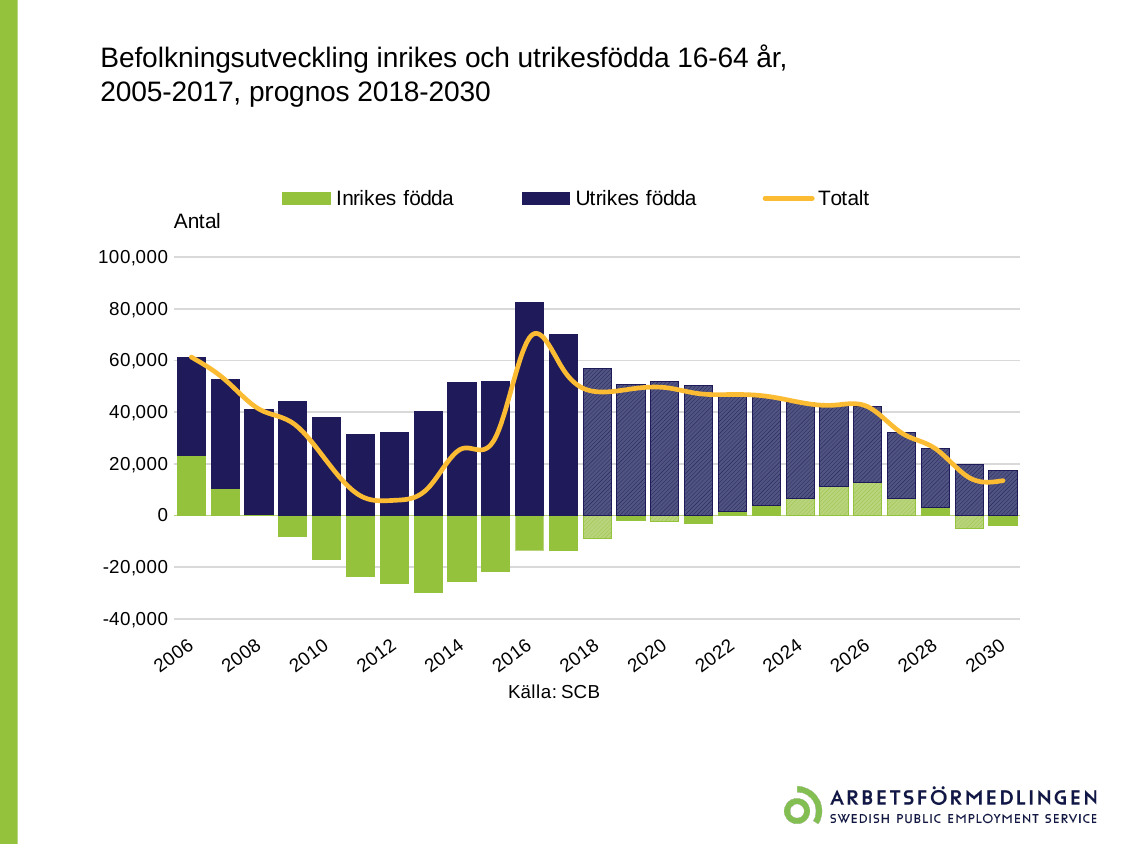
Is the Utrikes födda value for 2016 greater or less than 60,000? greater What source is cited below the chart? Källa: SCB In which year is the Utrikes födda bar the highest? 2016 How many series does the legend list? 3 In which year is the Inrikes födda value the highest? 2006 Is the Totalt value for 2030 greater or less than 20,000? less Does the Totalt line rise or fall from 2026 to 2030? Falls In which year is the Inrikes födda value the lowest (most negative)? 2013 Which is larger, the Utrikes födda value for 2016 or for 2017? 2016 Is the Inrikes födda value for 2013 greater or less than -20,000? less What kind of chart is shown on the slide? A stacked bar chart with a line How many years (bars) are plotted along the x axis? 25